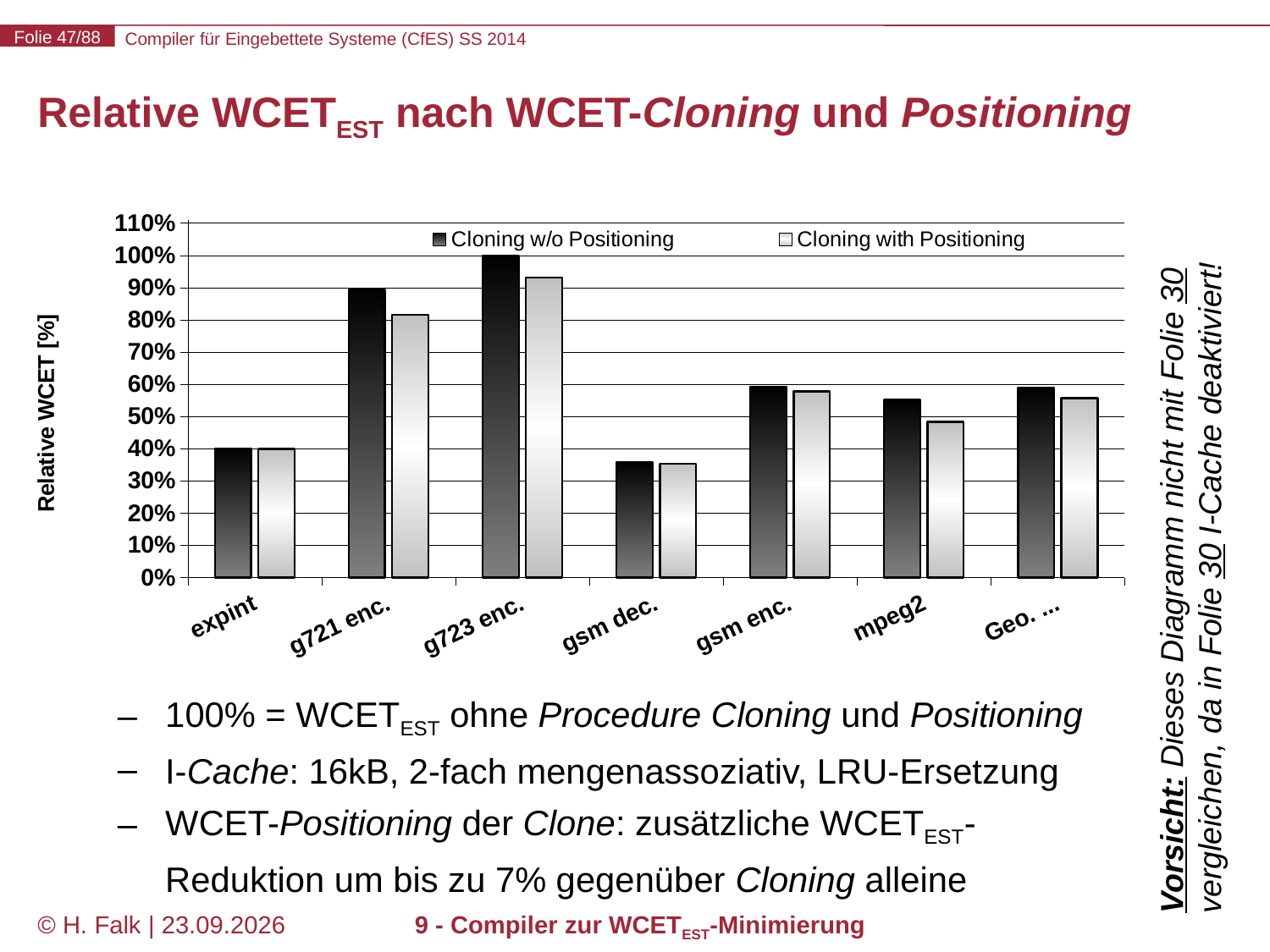
What is the label of the chart's y axis? Relative WCET [%] What kind of chart is shown on the slide? bar chart Which category has the highest value for the 'Cloning with Positioning' series? g723 enc. Which category has the lowest value for the 'Cloning with Positioning' series? gsm dec. Which category has the highest value for the 'Cloning w/o Positioning' series? g723 enc. Is the 'Cloning w/o Positioning' value for g721 enc. greater or less than 80%? greater What is the 'Cloning w/o Positioning' value for g723 enc.? 100% Is the 'Cloning with Positioning' value for gsm dec. greater or less than 40%? less For mpeg2, which series has the larger value: 'Cloning w/o Positioning' or 'Cloning with Positioning'? Cloning w/o Positioning How many series does the chart's legend list? 2 How many categories are shown on the x axis of the chart? 7 Is the 'Cloning with Positioning' value for mpeg2 greater or less than 50%? less